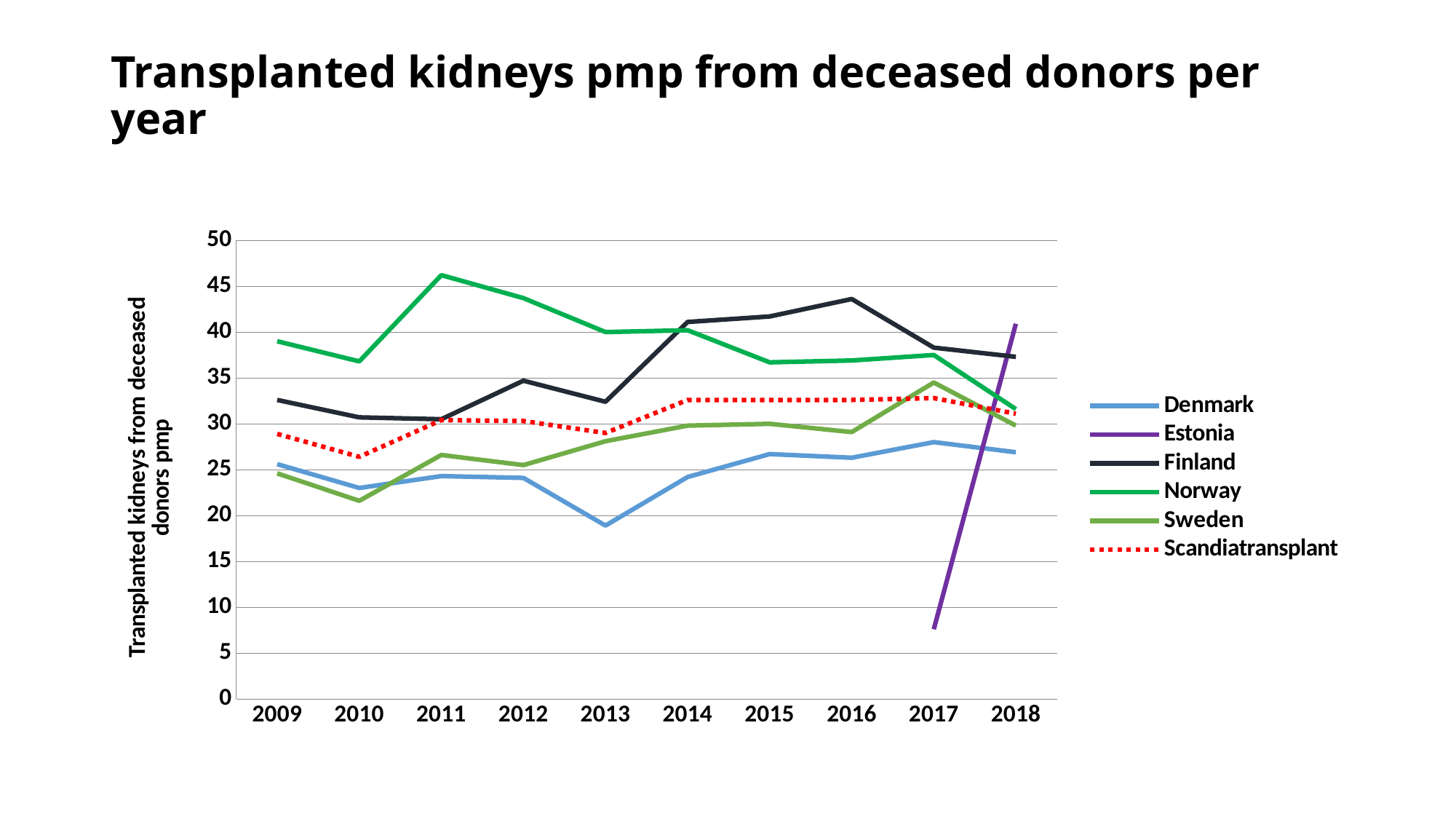
How many series does the legend list? 6 In 2016, which is larger: the value for Finland or the value for Norway? Finland What kind of chart is shown on the slide? line chart Is the value for Estonia in 2017 greater or less than 10? less Which series has the lowest value in 2013? Denmark In 2014, which is larger: the value for Denmark or the value for Sweden? Sweden Is the value for Norway in 2011 greater or less than 40? greater Which series has the highest value in 2011? Norway Is the value for Denmark in 2013 greater or less than 20? less How many years are shown on the x axis? 10 Does the Estonia line rise or fall from 2017 to 2018? rise Which series is drawn with a dotted line? Scandiatransplant